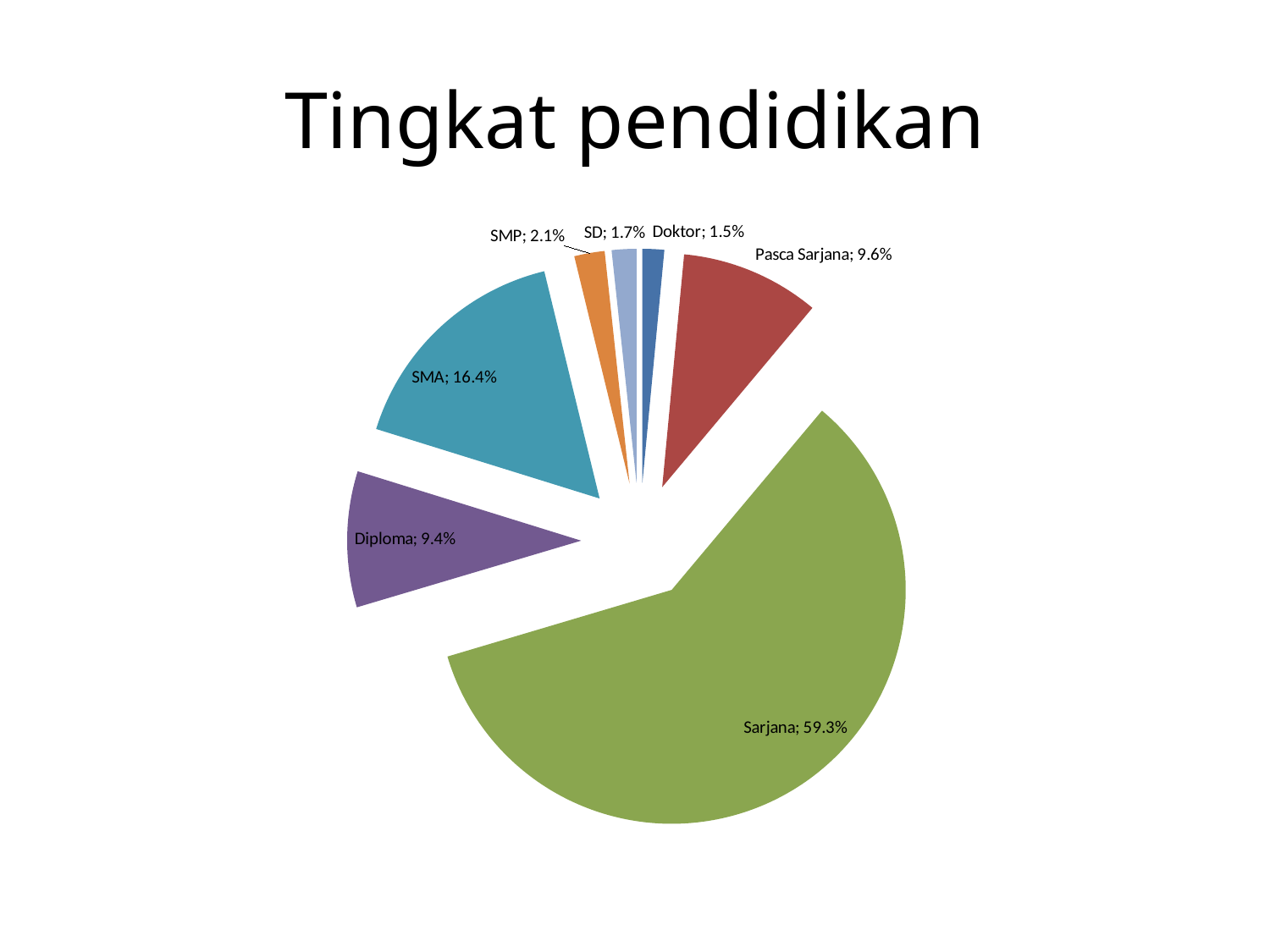
What is the difference between the shares of SMA and Diploma? 7.0% Which is larger, the share for Pasca Sarjana or the share for Diploma? Pasca Sarjana What is the share for Pasca Sarjana? 9.6% What is the share for Doktor? 1.5% What is the share for Sarjana? 59.3% What is the share for SMA? 16.4% Which category has the largest slice? Sarjana Which category has the smallest slice? Doktor What is the title of the chart? Tingkat pendidikan What is the difference between the shares of SMP and SD? 0.4% What type of chart is shown on the slide? Pie chart How many categories are shown in the pie chart? 7